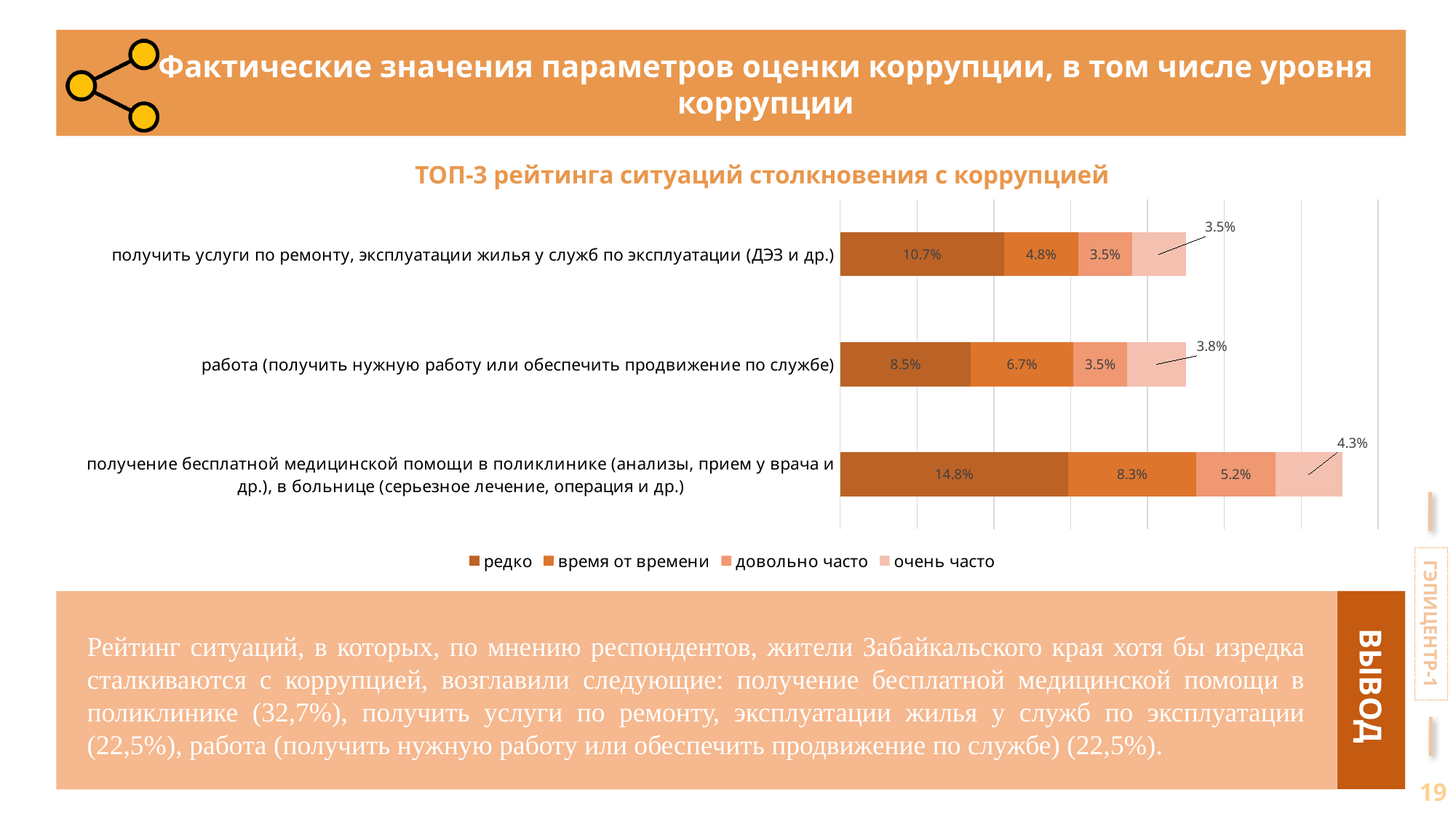
What is the value of the 'редко' series for the category 'получение бесплатной медицинской помощи в поликлинике (анализы, прием у врача и др.), в больнице (серьезное лечение, операция и др.)'? 14.8% Which is larger: the 'время от времени' value for 'работа (получить нужную работу или обеспечить продвижение по службе)' or for 'получить услуги по ремонту, эксплуатации жилья у служб по эксплуатации (ДЭЗ и др.)'? работа (получить нужную работу или обеспечить продвижение по службе) How many categories are plotted in the chart? 3 Which category has the lowest value for the 'очень часто' series? получить услуги по ремонту, эксплуатации жилья у служб по эксплуатации (ДЭЗ и др.) What is the difference between the 'редко' values for 'получение бесплатной медицинской помощи...' and 'работа (получить нужную работу или обеспечить продвижение по службе)'? 6.3% What is the value of the 'время от времени' series for the category 'работа (получить нужную работу или обеспечить продвижение по службе)'? 6.7% What is the value of the 'довольно часто' series for the category 'получение бесплатной медицинской помощи в поликлинике (анализы, прием у врача и др.), в больнице (серьезное лечение, операция и др.)'? 5.2% What is the value of the 'очень часто' series for the category 'получить услуги по ремонту, эксплуатации жилья у служб по эксплуатации (ДЭЗ и др.)'? 3.5% Which category has the highest value for the 'редко' series? получение бесплатной медицинской помощи в поликлинике (анализы, прием у врача и др.), в больнице (серьезное лечение, операция и др.) What type of chart is shown on the slide? Stacked bar chart What is the total of the stacked bar for 'получить услуги по ремонту, эксплуатации жилья у служб по эксплуатации (ДЭЗ и др.)'? 22.5% How many series does the legend list? 4